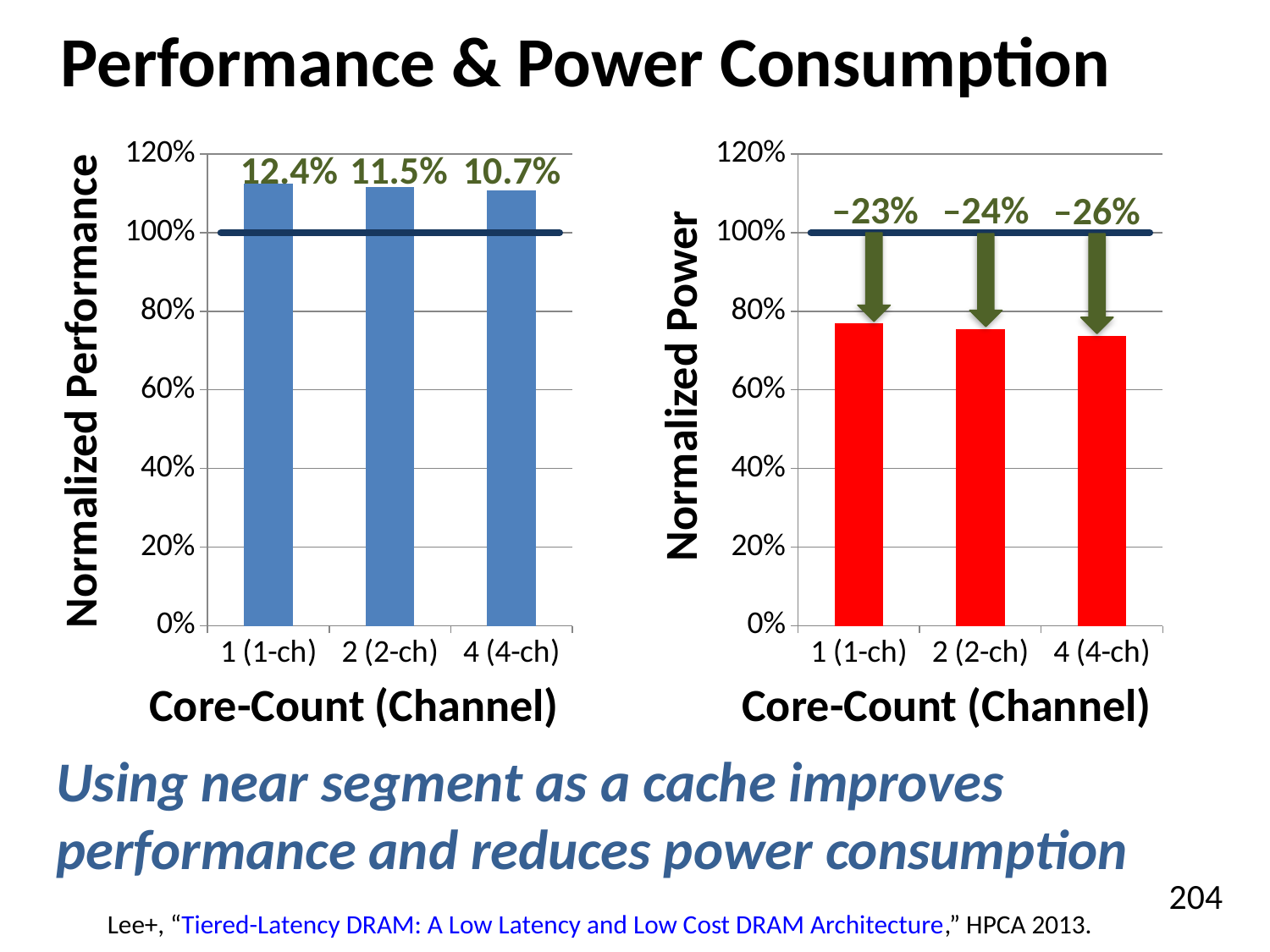
What colour are the bars on the Normalized Power chart? red What type of chart is the Normalized Performance chart on the left? bar chart On the Normalized Power chart, is the bar for 1 (1-ch) greater or less than 100%? less On the Normalized Performance chart, what improvement label is printed above the bar for 4 (4-ch)? 10.7% On the Normalized Performance chart, what improvement label is printed above the bar for 1 (1-ch)? 12.4% On the Normalized Performance chart, is the bar for 2 (2-ch) greater or less than 100%? greater On the Normalized Performance chart, do the labelled improvements rise or fall as the core count increases from 1 to 4? fall On the Normalized Power chart, which core-count configuration has the largest labelled power reduction? 4 (4-ch) How many core-count categories are shown on the Normalized Power chart on the right? 3 On the Normalized Performance chart, which core-count configuration has the largest labelled performance improvement? 1 (1-ch) On the Normalized Power chart, what reduction label is printed above the bar for 2 (2-ch)? –24% On the Normalized Power chart, what reduction label is printed above the bar for 4 (4-ch)? –26%